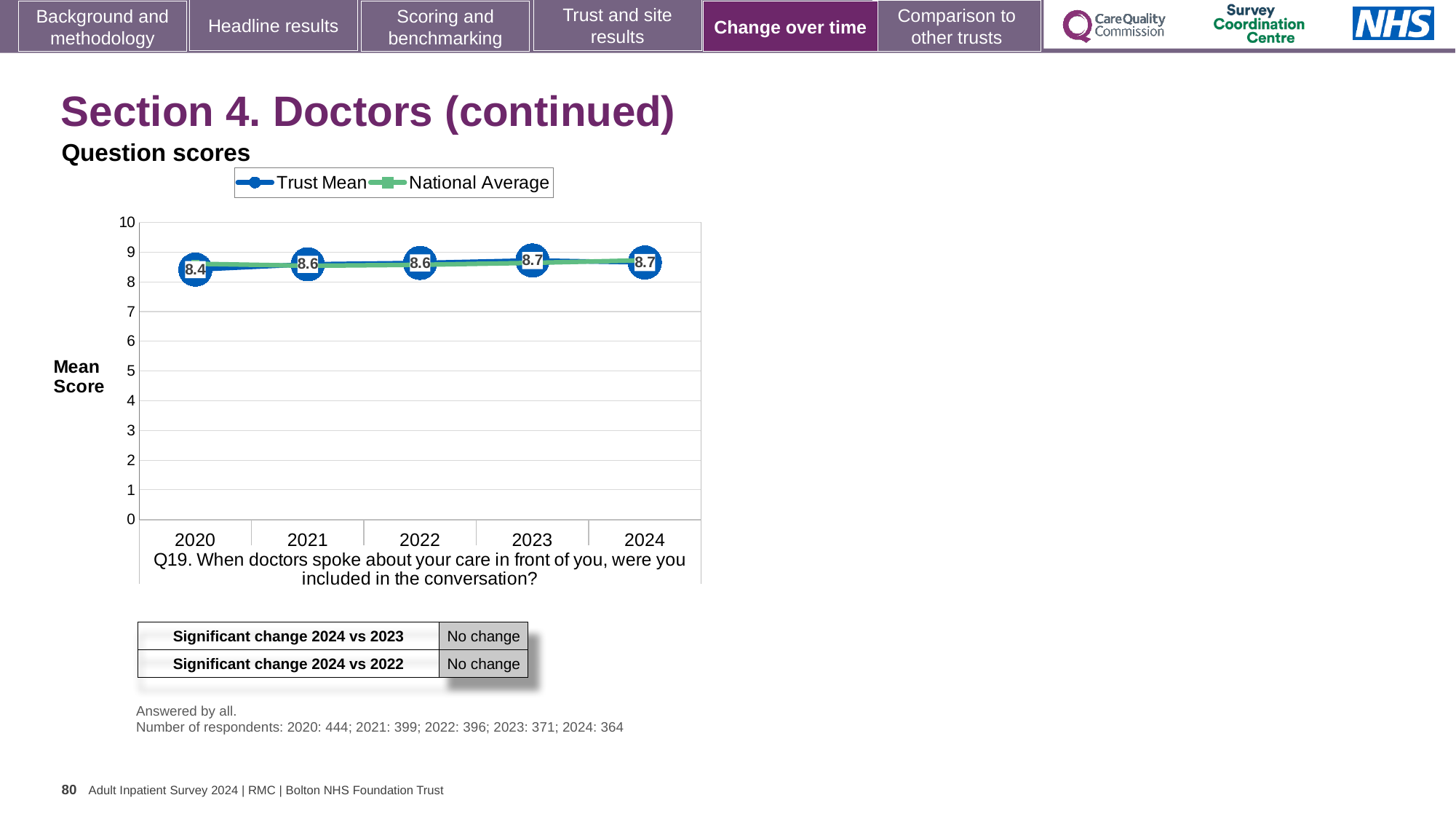
What is the Trust Mean score for 2020? 8.4 What kind of chart is shown on the slide? Line chart What is the difference between the Trust Mean score in 2024 and in 2020? 0.3 Is the National Average value for 2020 greater or less than 8? greater How many years are plotted on the x axis? 5 Does the Trust Mean score rise or fall from 2020 to 2024? Rise How many series does the legend list? 2 Which year has the higher Trust Mean score, 2020 or 2021? 2021 What is the Trust Mean score for 2024? 8.7 What is the label on the y axis of the chart? Mean Score What is the Trust Mean score for 2022? 8.6 In which year is the Trust Mean score lowest? 2020